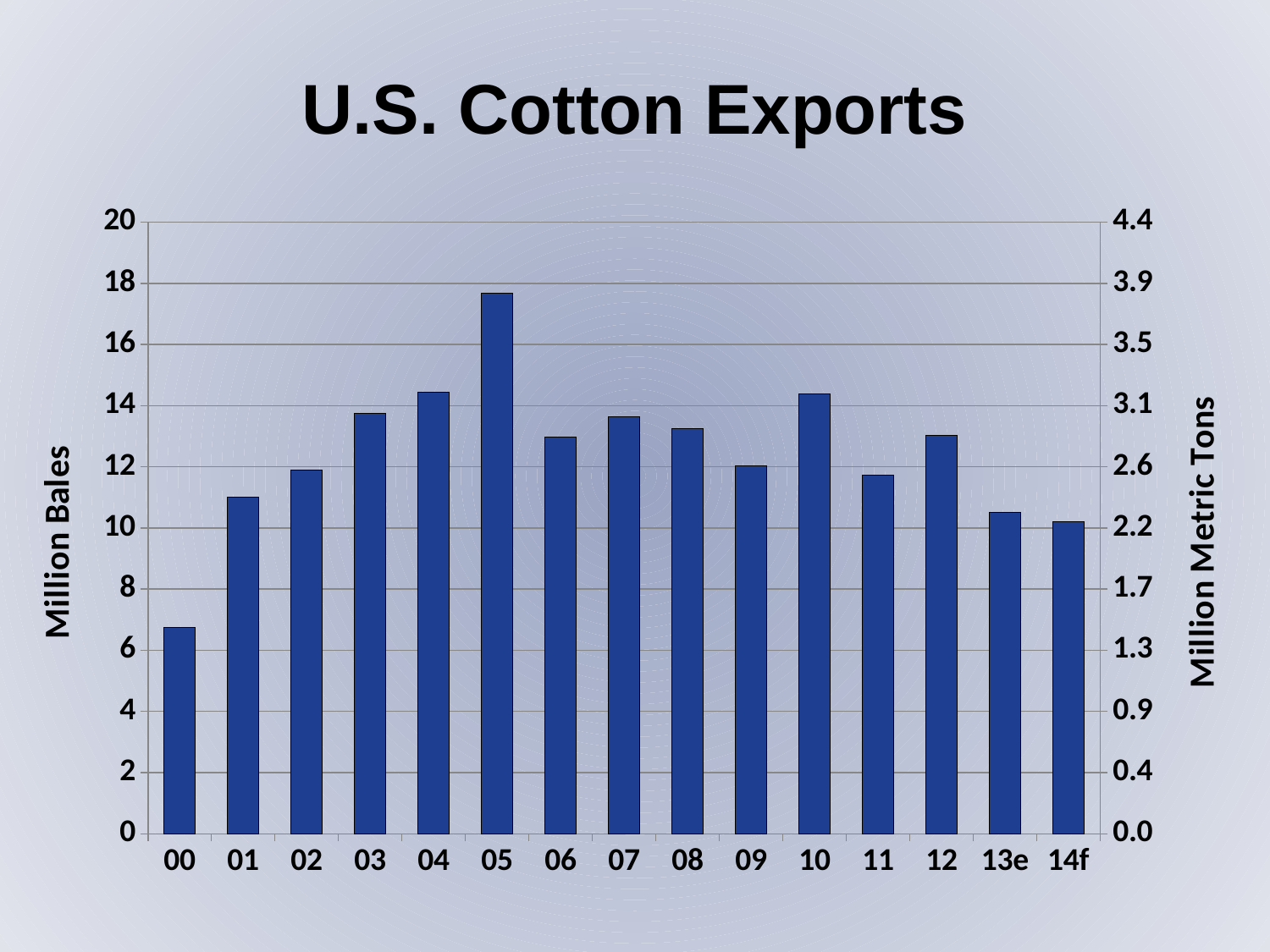
Is the value for 00 greater or less than 8 million bales? less Which year has the highest cotton exports? 05 Which is larger, the value for 04 or the value for 05? 05 Do the values rise or fall from 00 to 05? rise Which year has the lowest cotton exports? 00 How many years (categories) are shown on the x axis? 15 What type of chart is shown on the slide? bar chart What is the title of the chart? U.S. Cotton Exports Is the value for 09 greater or less than 10 million bales? greater Is the value for 05 greater or less than 16 million bales? greater What is the label of the left vertical axis? Million Bales